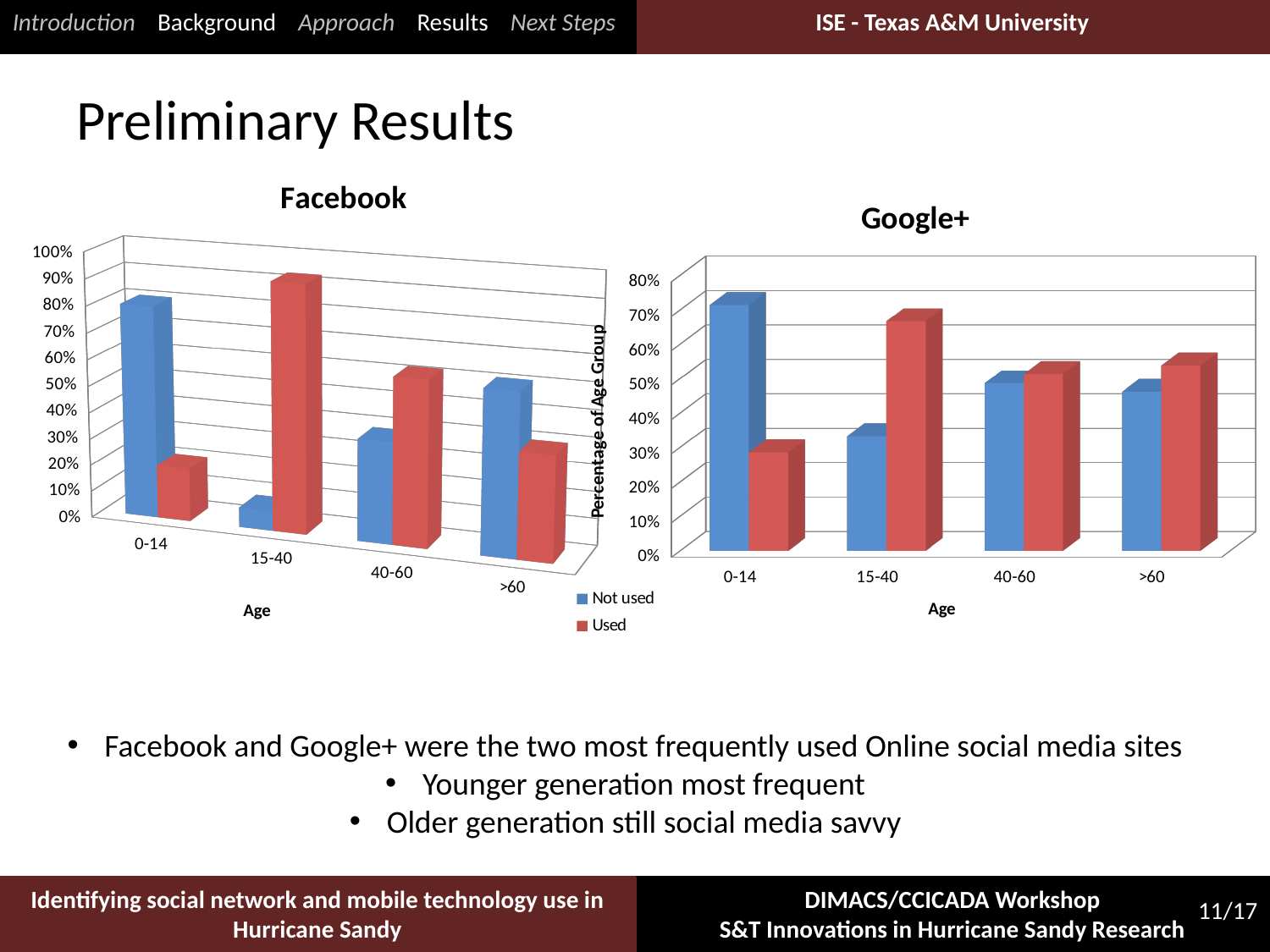
On the Google+ chart, which age group has the lowest 'Used' value? 0-14 On the Facebook chart, which age group has the highest 'Used' value? 15-40 On the Facebook chart, which is larger for the 0-14 age group, 'Not used' or 'Used'? Not used On the Facebook chart, which age group has the lowest 'Not used' value? 15-40 On the Google+ chart, which age group has the highest 'Not used' value? 0-14 On the Facebook chart, is the 'Not used' value for 0-14 greater or less than 70%? greater What kind of chart is the Facebook chart? bar chart On the Google+ chart, which is larger for the 15-40 age group, 'Not used' or 'Used'? Used How many age groups are shown on the Google+ chart? 4 How many series does the legend on the Facebook chart list? 2 On the Google+ chart, is the 'Used' value for 15-40 greater or less than 60%? greater What is the y-axis title on the Google+ chart? Percentage of Age Group